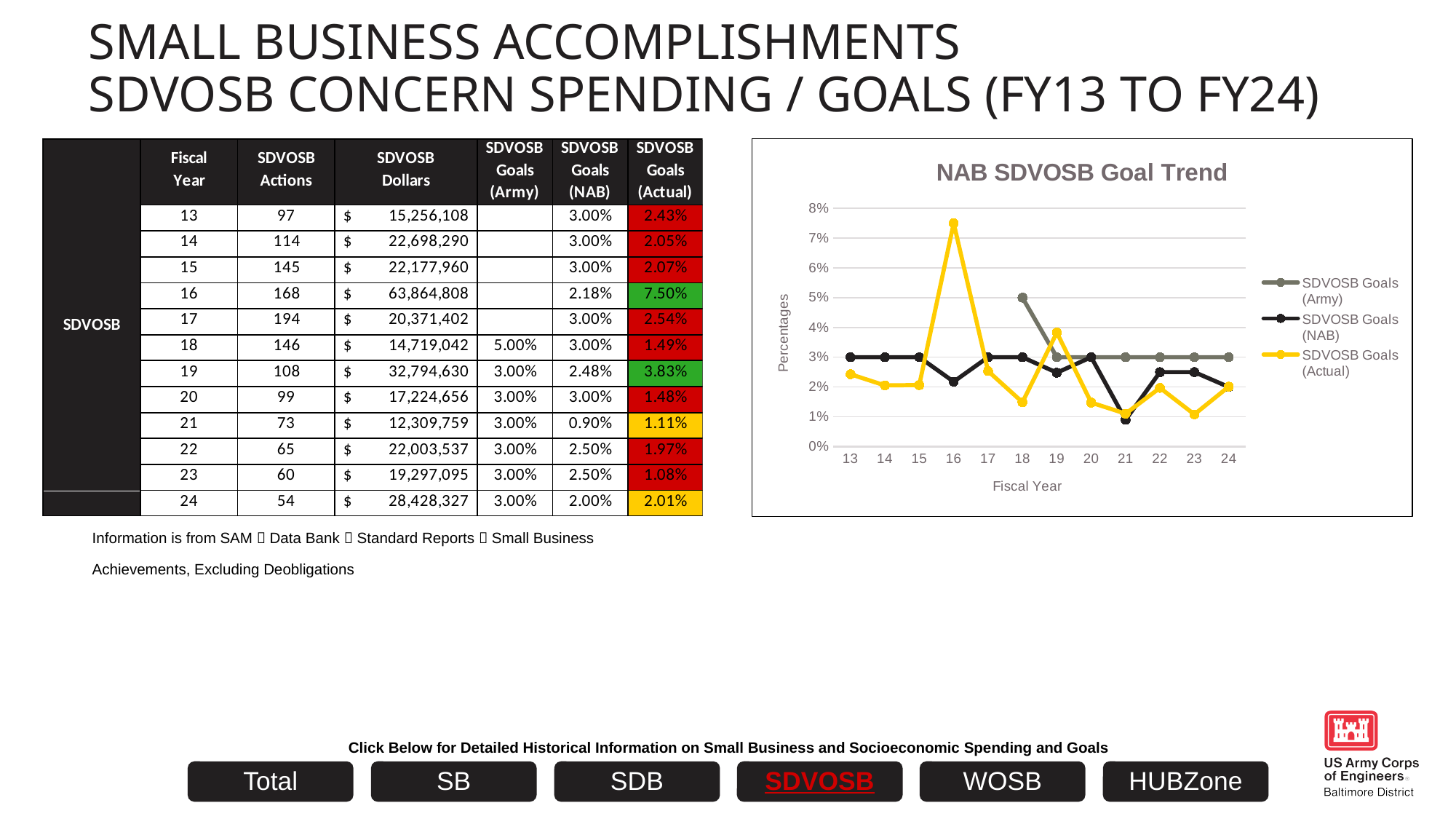
In the NAB SDVOSB Goal Trend chart, is the SDVOSB Goals (Actual) value for fiscal year 16 greater or less than 6%? greater How many fiscal years are shown on the x axis of the NAB SDVOSB Goal Trend chart? 12 In the NAB SDVOSB Goal Trend chart, does the SDVOSB Goals (Army) series rise or fall from fiscal year 18 to fiscal year 19? Fall How many series does the legend of the NAB SDVOSB Goal Trend chart list? 3 In the NAB SDVOSB Goal Trend chart, in which fiscal year does the SDVOSB Goals (Actual) series reach its highest value? 16 What is the SDVOSB Goals (Army) value for fiscal year 18 shown on the slide? 5.00% What colour is the SDVOSB Goals (Actual) line in the NAB SDVOSB Goal Trend chart? Yellow In the NAB SDVOSB Goal Trend chart, which is higher in fiscal year 19: SDVOSB Goals (Actual) or SDVOSB Goals (NAB)? SDVOSB Goals (Actual) What kind of chart is the NAB SDVOSB Goal Trend chart? Line chart In the NAB SDVOSB Goal Trend chart, is the SDVOSB Goals (NAB) value for fiscal year 21 greater or less than 2%? less In the NAB SDVOSB Goal Trend chart, in which fiscal year is the SDVOSB Goals (NAB) series at its lowest? 21 In the NAB SDVOSB Goal Trend chart, is the SDVOSB Goals (Actual) value for fiscal year 13 greater or less than 3%? less